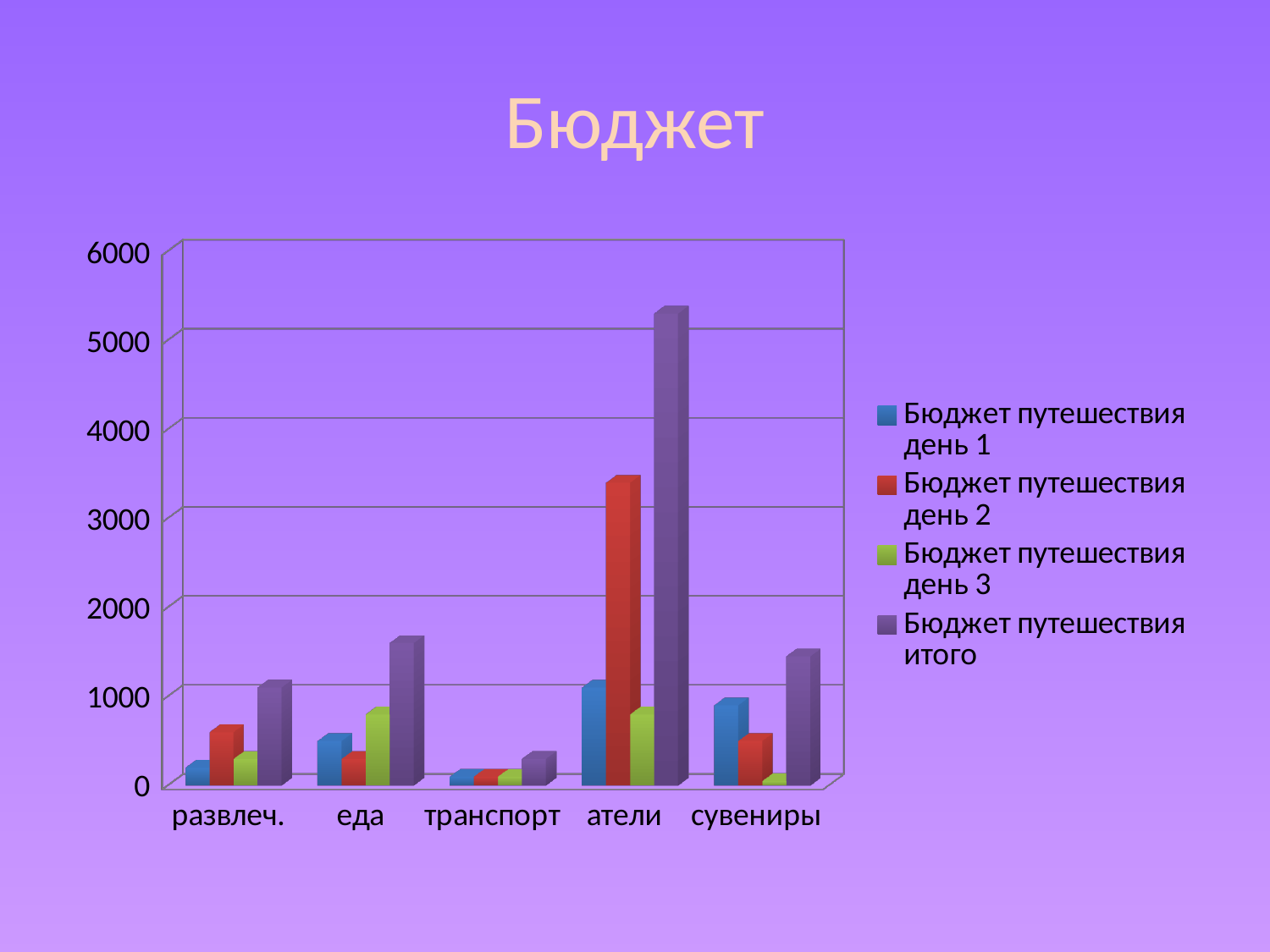
What is the title of the chart? Бюджет Is the value for 'еда' in the series 'Бюджет путешествия итого' greater or less than 1000? greater Is the value for 'атели' in the series 'Бюджет путешествия итого' greater or less than 5000? greater For the category 'атели', which is larger: the value for 'Бюджет путешествия день 1' or 'Бюджет путешествия день 2'? Бюджет путешествия день 2 How many series does the legend list? 4 How many categories are shown on the x axis? 5 Which category has the highest value for the series 'Бюджет путешествия итого'? атели Which colour represents the series 'Бюджет путешествия день 3' in the legend? green Is the value for 'атели' in the series 'Бюджет путешествия день 2' greater or less than 3000? greater What kind of chart is shown on the slide? bar chart Which category has the lowest value for the series 'Бюджет путешествия итого'? транспорт